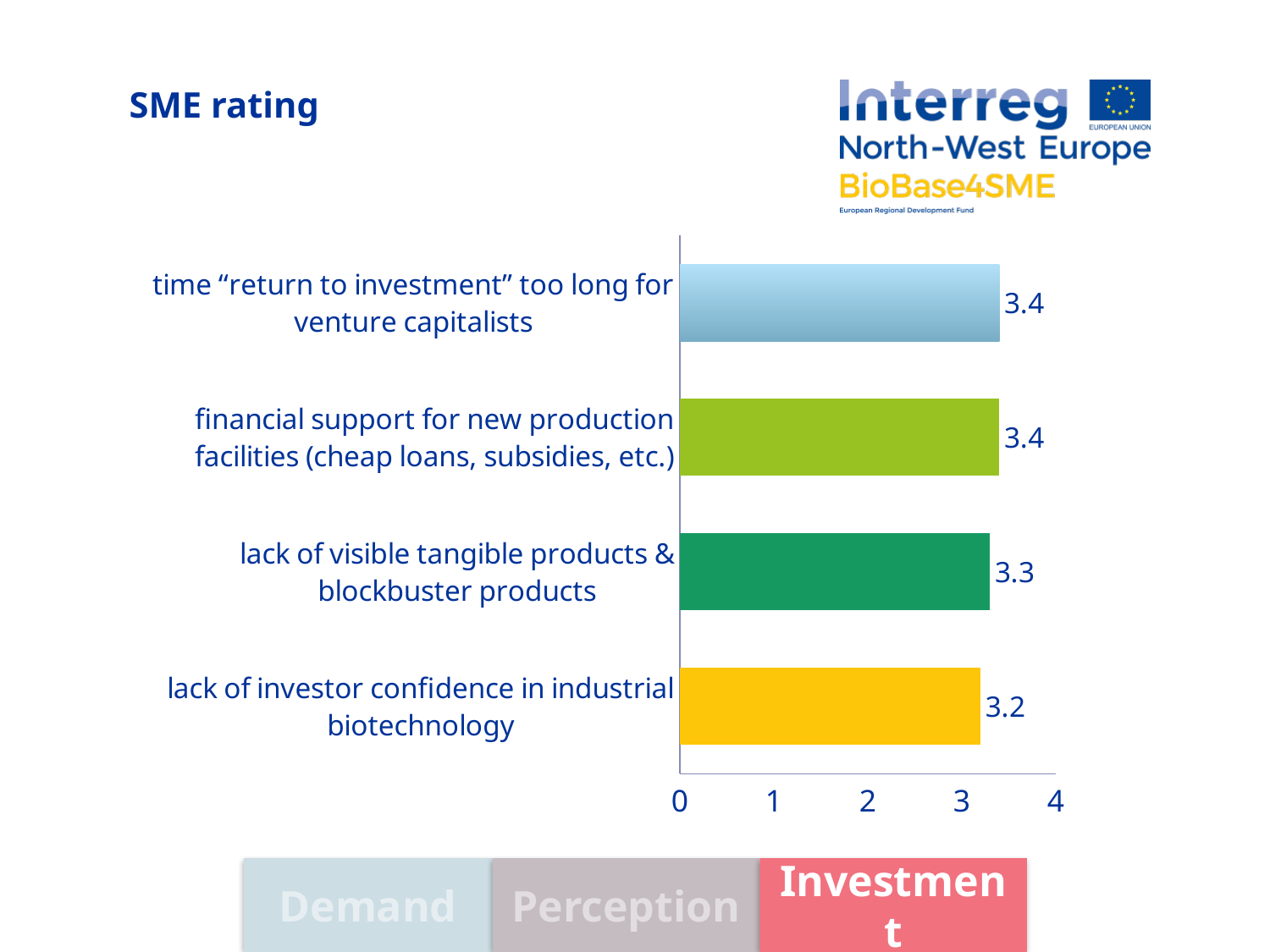
What is the value for "financial support for new production facilities (cheap loans, subsidies, etc.)"? 3.4 What is the value for "time "return to investment" too long for venture capitalists"? 3.4 What is the difference between the value for "lack of visible tangible products & blockbuster products" and the value for "lack of investor confidence in industrial biotechnology"? 0.1 What is the difference between the value for "financial support for new production facilities (cheap loans, subsidies, etc.)" and the value for "lack of investor confidence in industrial biotechnology"? 0.2 Which is larger: the value for "lack of visible tangible products & blockbuster products" or the value for "lack of investor confidence in industrial biotechnology"? lack of visible tangible products & blockbuster products Is the value for "lack of investor confidence in industrial biotechnology" greater or less than 3? greater What is the maximum value shown on the horizontal axis? 4 What kind of chart is shown on the slide? bar chart What is the value for "lack of investor confidence in industrial biotechnology"? 3.2 Which category has the lowest value? lack of investor confidence in industrial biotechnology How many categories are shown in the chart? 4 What is the value for "lack of visible tangible products & blockbuster products"? 3.3